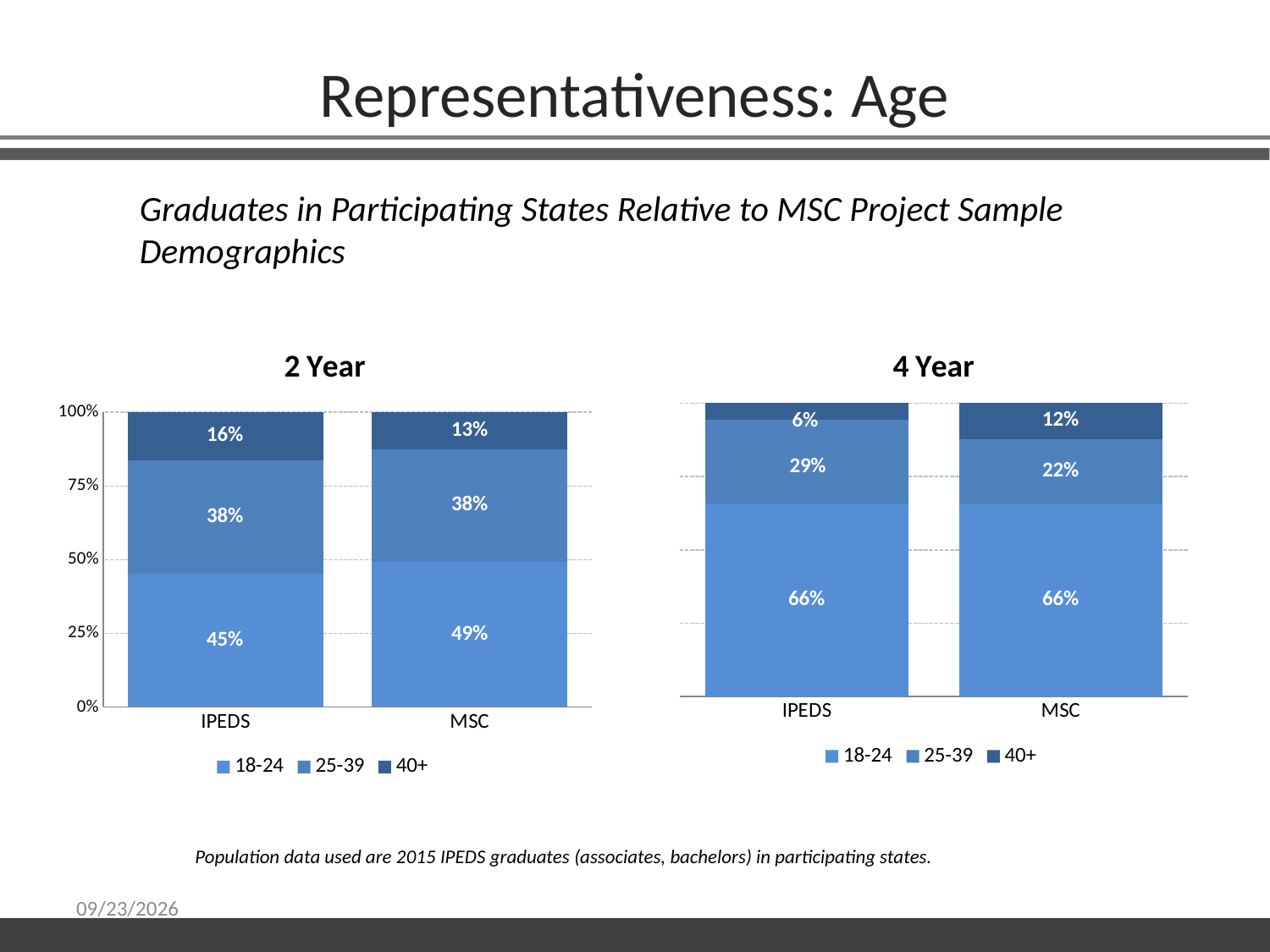
In the 2 Year chart, what is the difference between the 18-24 values for MSC and IPEDS? 4% In the 4 Year chart, which segment of the IPEDS bar is the smallest? 40+ How many categories are shown on the x axis of the 4 Year chart? 2 In the 4 Year chart, what is the value for the 25-39 segment of the IPEDS bar? 29% In the 2 Year chart, what is the value for the 18-24 segment of the IPEDS bar? 45% In the 2 Year chart, what is the value for the 40+ segment of the MSC bar? 13% In the 2 Year chart, which segment of the IPEDS bar is the largest? 18-24 What kind of chart is the 2 Year chart? Stacked bar chart In the 4 Year chart, which bar has the larger 40+ segment, IPEDS or MSC? MSC In the 4 Year chart, what is the value for the 40+ segment of the MSC bar? 12% How many series does the legend of the 2 Year chart list? 3 In the 4 Year chart, what is the difference between the 25-39 values for IPEDS and MSC? 7%